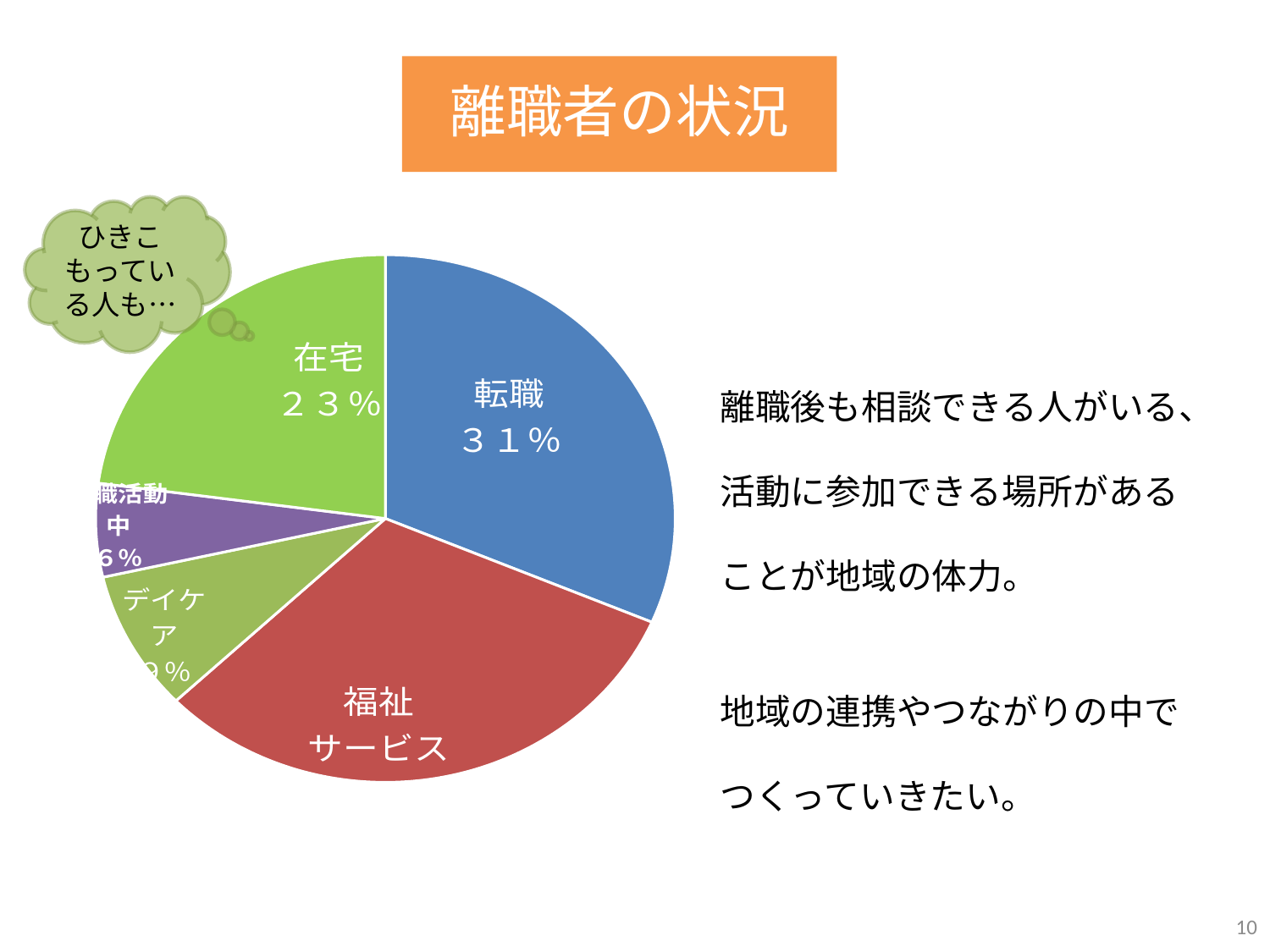
What percentage does the 転職 slice show? 31% What colour is the 転職 slice? blue What is the title of the slide containing the pie chart? 離職者の状況 What percentage does the 就職活動中 slice show? 6% Which is larger, the 転職 slice or the 在宅 slice? 転職 What percentage does the 在宅 slice show? 23% What is the difference in percentage points between the 転職 slice and the 在宅 slice? 8 Which is larger, the 在宅 slice or the デイケア slice? 在宅 What kind of chart is shown on the slide? pie chart What is the difference in percentage points between the 在宅 slice and the 就職活動中 slice? 17 Which slice of the pie chart is the smallest? 就職活動中 How many slices does the pie chart have? 5